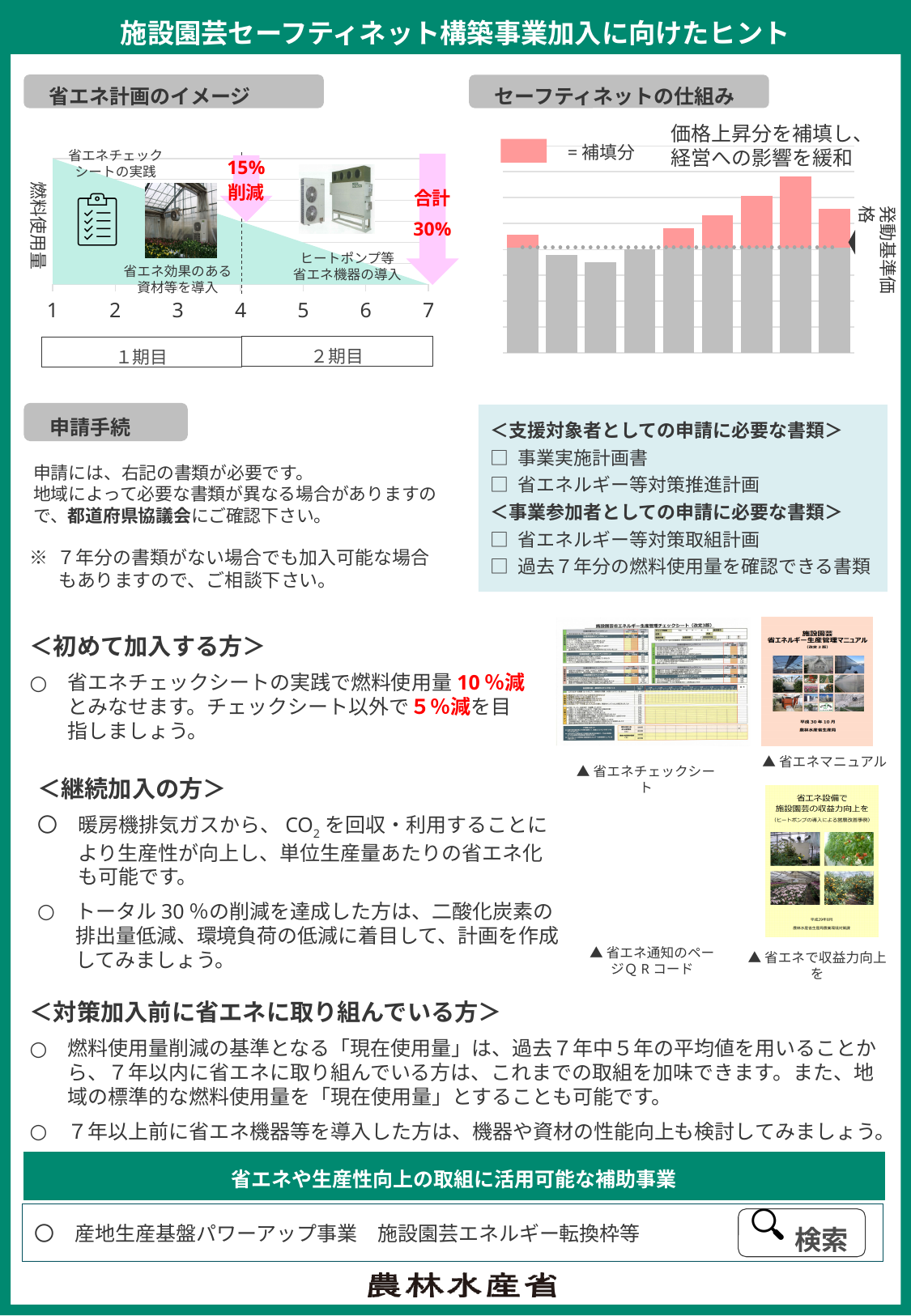
In the chart titled 「セーフティネットの仕組み」, what kind of chart is it? bar chart In the chart titled 「セーフティネットの仕組み」, do the bars rise or fall from the 5th bar to the 8th bar? rise In the chart titled 「省エネ計画のイメージ」, does the plotted fuel usage (燃料使用量) rise or fall from point 1 to point 7? fall In the chart titled 「セーフティネットの仕組み」, which bar (counting from the left) is the tallest? the 8th bar In the chart titled 「省エネ計画のイメージ」, what total reduction is labelled at point 7 on the x axis? 合計30% In the chart titled 「省エネ計画のイメージ」, how many points are marked on the x axis? 7 In the chart titled 「セーフティネットの仕組み」, what is the label on the right-hand axis marking the dotted baseline? 発動基準価格 In the chart titled 「省エネ計画のイメージ」, what reduction is labelled at point 4 on the x axis? 15%削減 In the chart titled 「セーフティネットの仕組み」, is the 8th bar from the left taller or shorter than the 9th bar? taller In the chart titled 「セーフティネットの仕組み」, what does the pink colour represent according to the legend? 補填分 In the chart titled 「セーフティネットの仕組み」, how many bars are plotted? 9 In the chart titled 「セーフティネットの仕組み」, which bar (counting from the left) is the shortest? the 3rd bar